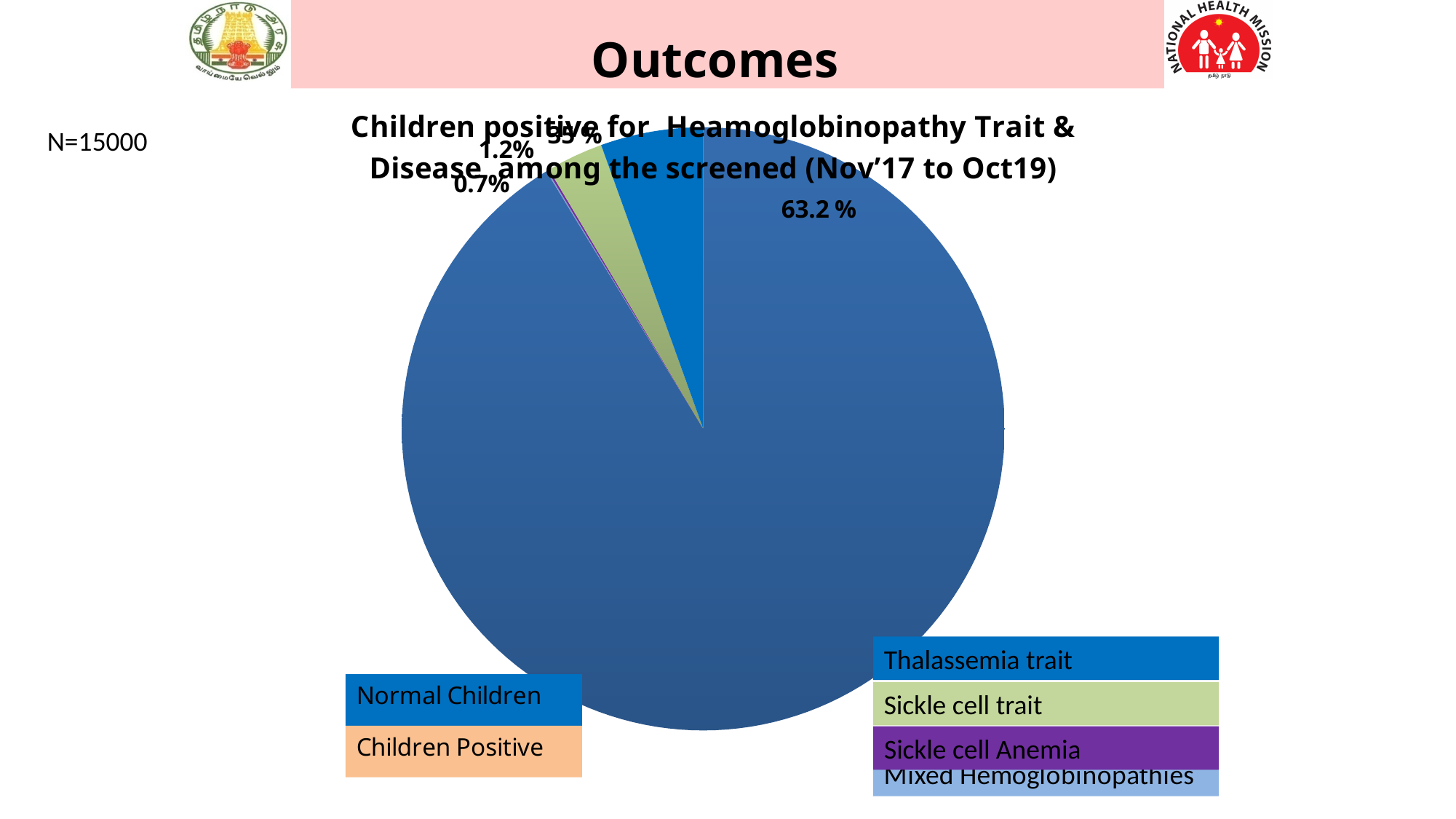
Which legend entry is shown in green? Sickle cell trait Which category has the largest slice of the pie? Normal Children What sample size (N) is stated on the slide? N=15000 What kind of chart is shown on the slide? pie chart How many entries does the chart's legend list? 6 What is the title of the chart? Children positive for Heamoglobinopathy Trait & Disease among the screened (Nov'17 to Oct19) Which slice is larger, Normal Children or Sickle cell trait? Normal Children What percentage label is printed on the largest slice of the pie? 63.2 %